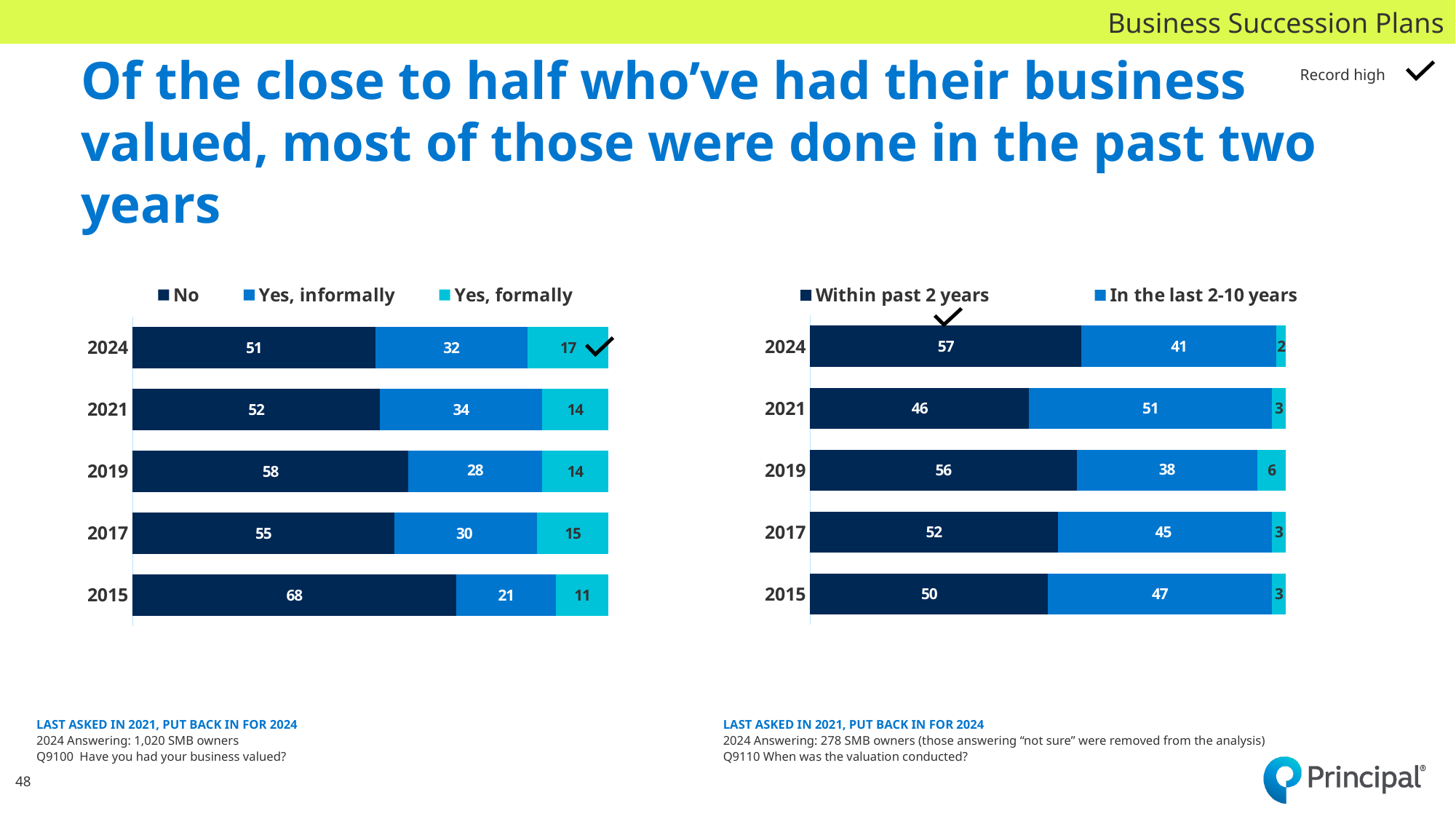
In the right chart (When was the valuation conducted?), what is the value for "In the last 2-10 years" in 2021? 51 What type of chart is the left chart (Have you had your business valued?)? Stacked bar chart In the left chart (Have you had your business valued?), what is the difference between the "No" values for 2015 and 2024? 17 In the right chart (When was the valuation conducted?), what is the value for "Within past 2 years" in 2024? 57 In the left chart (Have you had your business valued?), how many series does the legend list? 3 In the right chart (When was the valuation conducted?), which year has the lowest value for "Within past 2 years"? 2021 In the left chart (Have you had your business valued?), what is the value for "No" in 2024? 51 How many years are shown on the x axis of the right chart (When was the valuation conducted?)? 5 In the left chart (Have you had your business valued?), which year has the lowest value for "Yes, informally"? 2015 In the left chart (Have you had your business valued?), which year has the highest value for "No"? 2015 In the left chart (Have you had your business valued?), what is the value for "Yes, formally" in 2015? 11 In the right chart (When was the valuation conducted?), is the "In the last 2-10 years" value larger in 2019 or in 2017? 2017